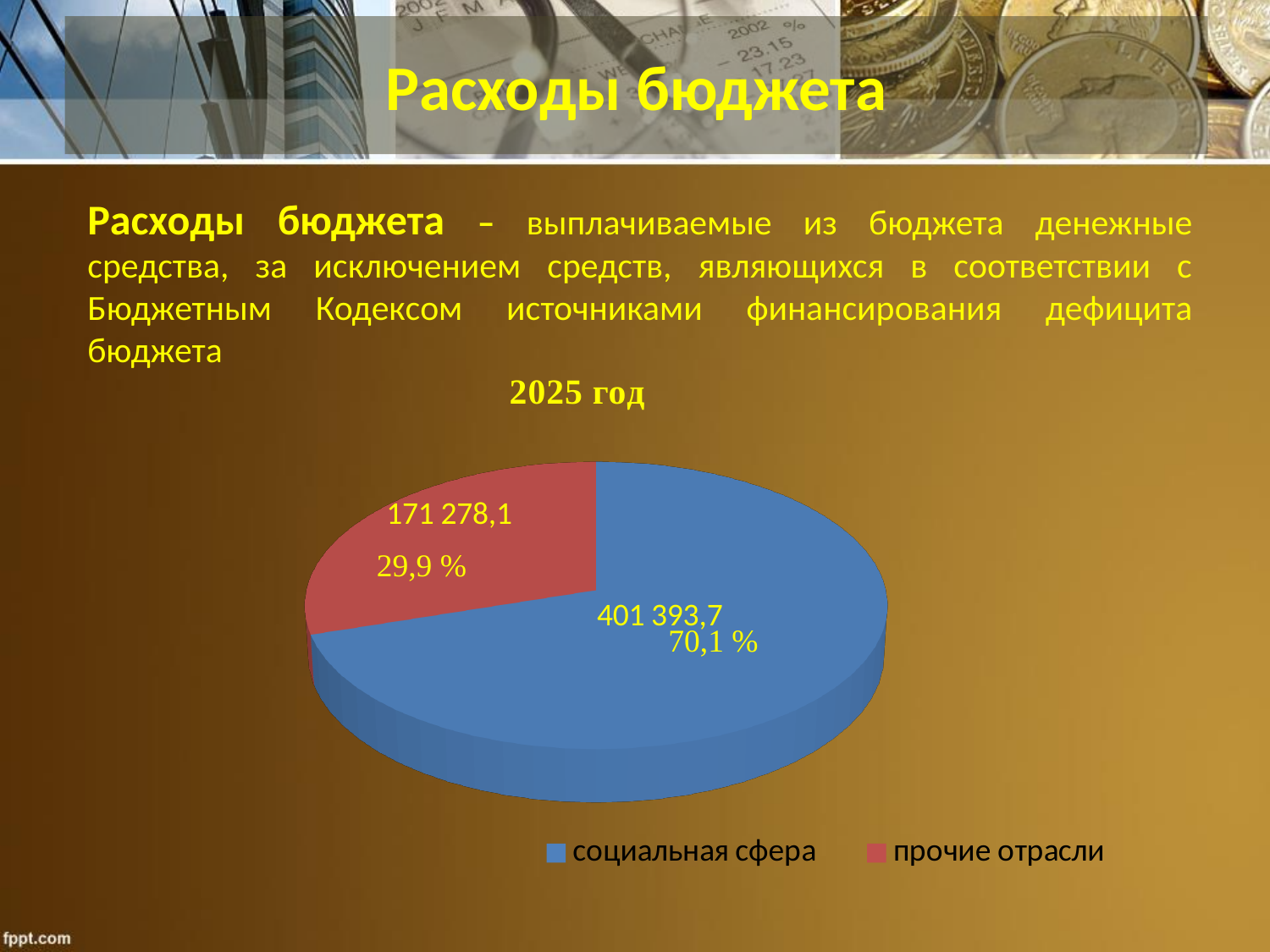
What is the difference between the values for социальная сфера and прочие отрасли? 230 115,6 Which colour represents прочие отрасли in the legend? red How many categories does the pie chart have? 2 What is the value for социальная сфера? 401 393,7 Which is larger, социальная сфера or прочие отрасли? социальная сфера What is the chart's title? 2025 год What share of the pie does прочие отрасли take? 29,9 % What is the value for прочие отрасли? 171 278,1 What share of the pie does социальная сфера take? 70,1 % Which category has the smallest slice? прочие отрасли Which category has the largest slice? социальная сфера What kind of chart is shown on the slide? pie chart